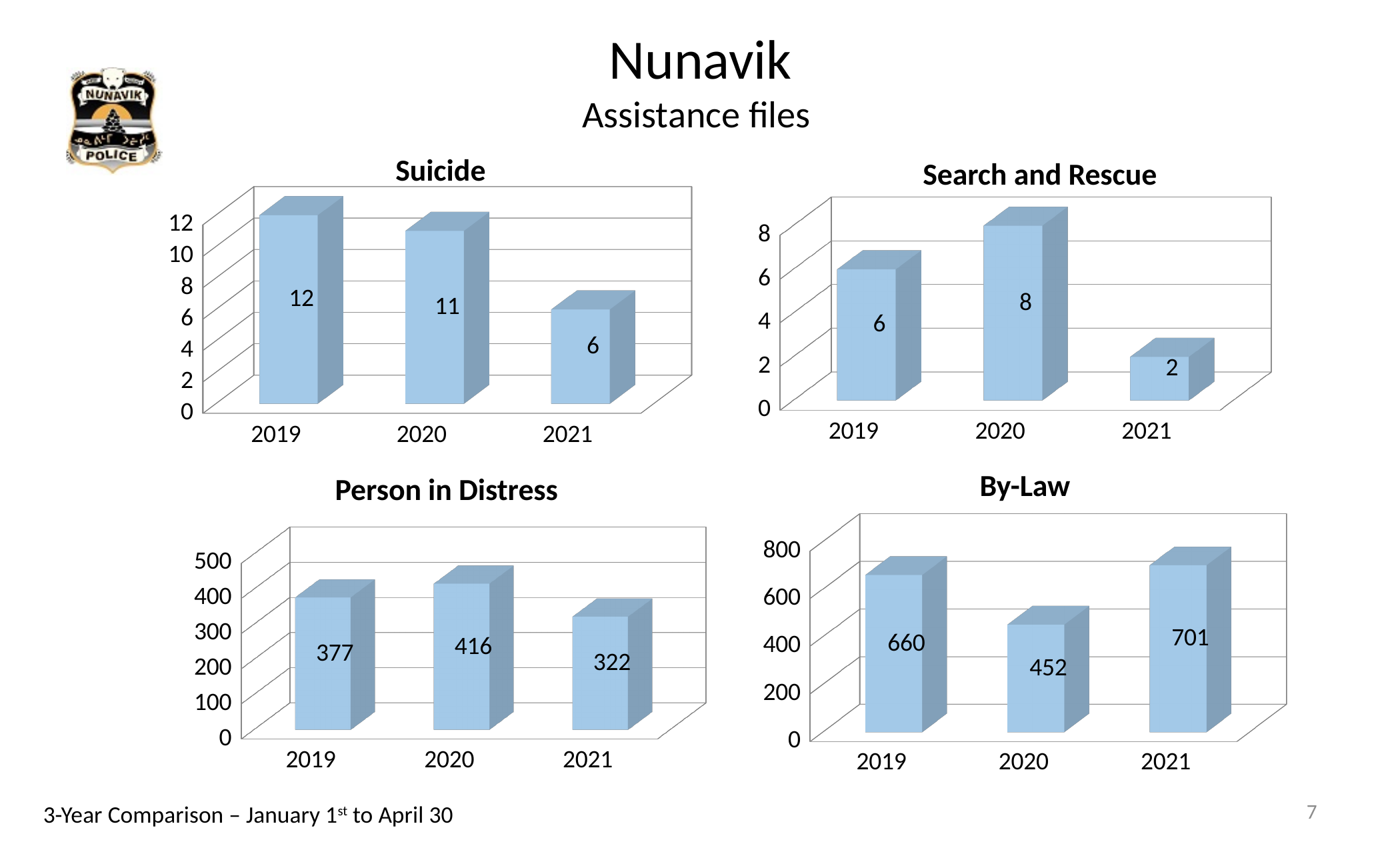
In the Suicide chart, what is the value for 2019? 12 In the Search and Rescue chart, which year has the highest value? 2020 In the Suicide chart, do the values rise or fall from 2019 to 2021? fall How many years are shown on the x axis of the Person in Distress chart? 3 In the By-Law chart, what is the difference between the 2021 and 2020 values? 249 In the By-Law chart, which is larger, the value for 2019 or the value for 2021? 2021 In the Person in Distress chart, what is the difference between the 2020 and 2019 values? 39 What is the title of the chart in the bottom-right of the slide? By-Law In the Person in Distress chart, which year has the lowest value? 2021 In the By-Law chart, what is the value for 2020? 452 In the Search and Rescue chart, what is the value for 2021? 2 What kind of chart is the Search and Rescue chart? bar chart